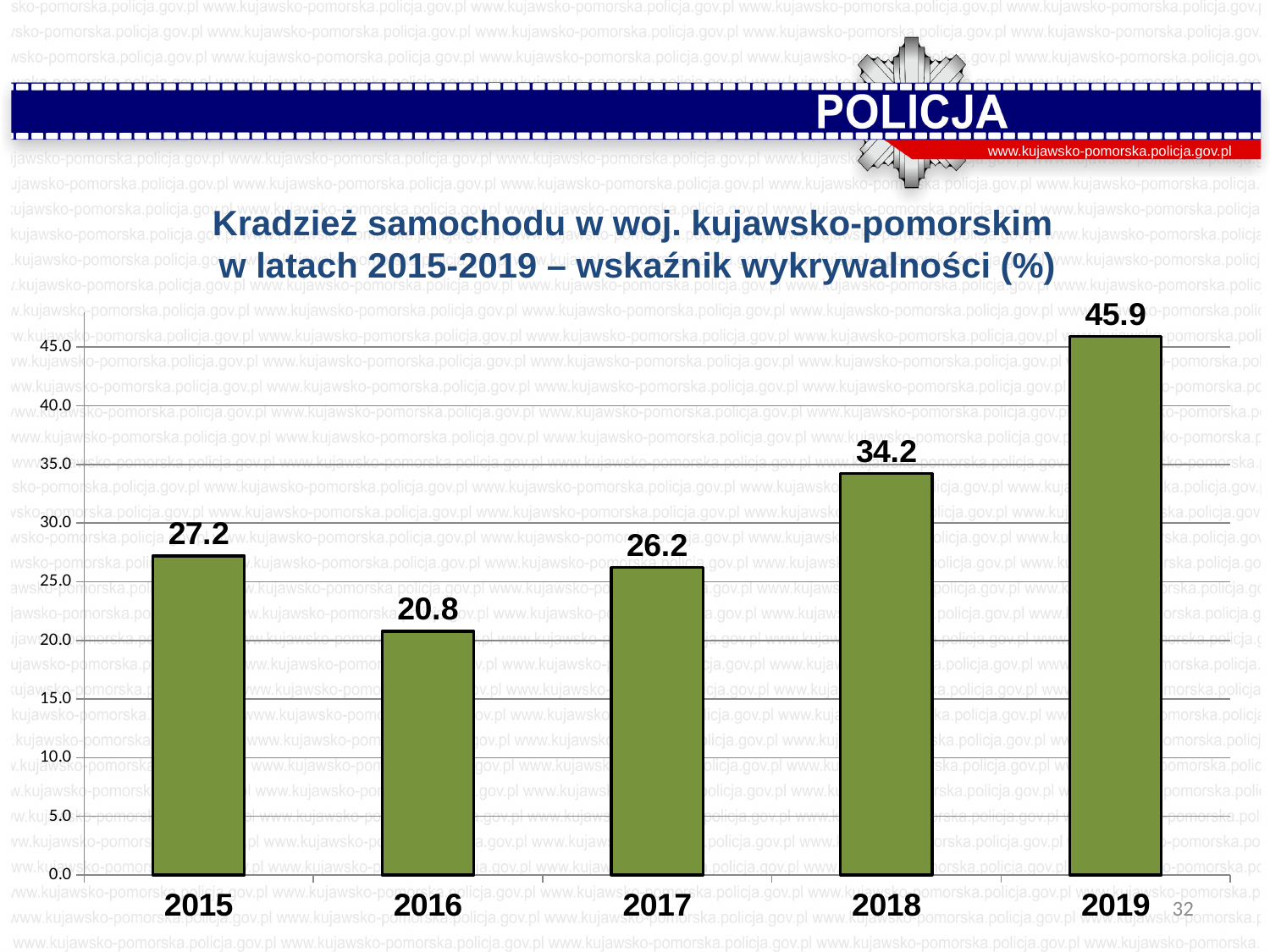
Which year has the lowest detection rate? 2016 Which year has a higher detection rate, 2017 or 2015? 2015 What is the detection rate for 2015? 27.2 What is the difference between the detection rate in 2015 and in 2016? 6.4 What is the detection rate for 2018? 34.2 How many years are shown on the chart? 5 Which year has the highest detection rate? 2019 What kind of chart is shown on the slide? bar chart Do the values rise or fall from 2016 to 2019? rise What is the difference between the detection rate in 2019 and in 2018? 11.7 Is the value for 2017 greater or less than 25.0? greater What is the detection rate for 2016? 20.8